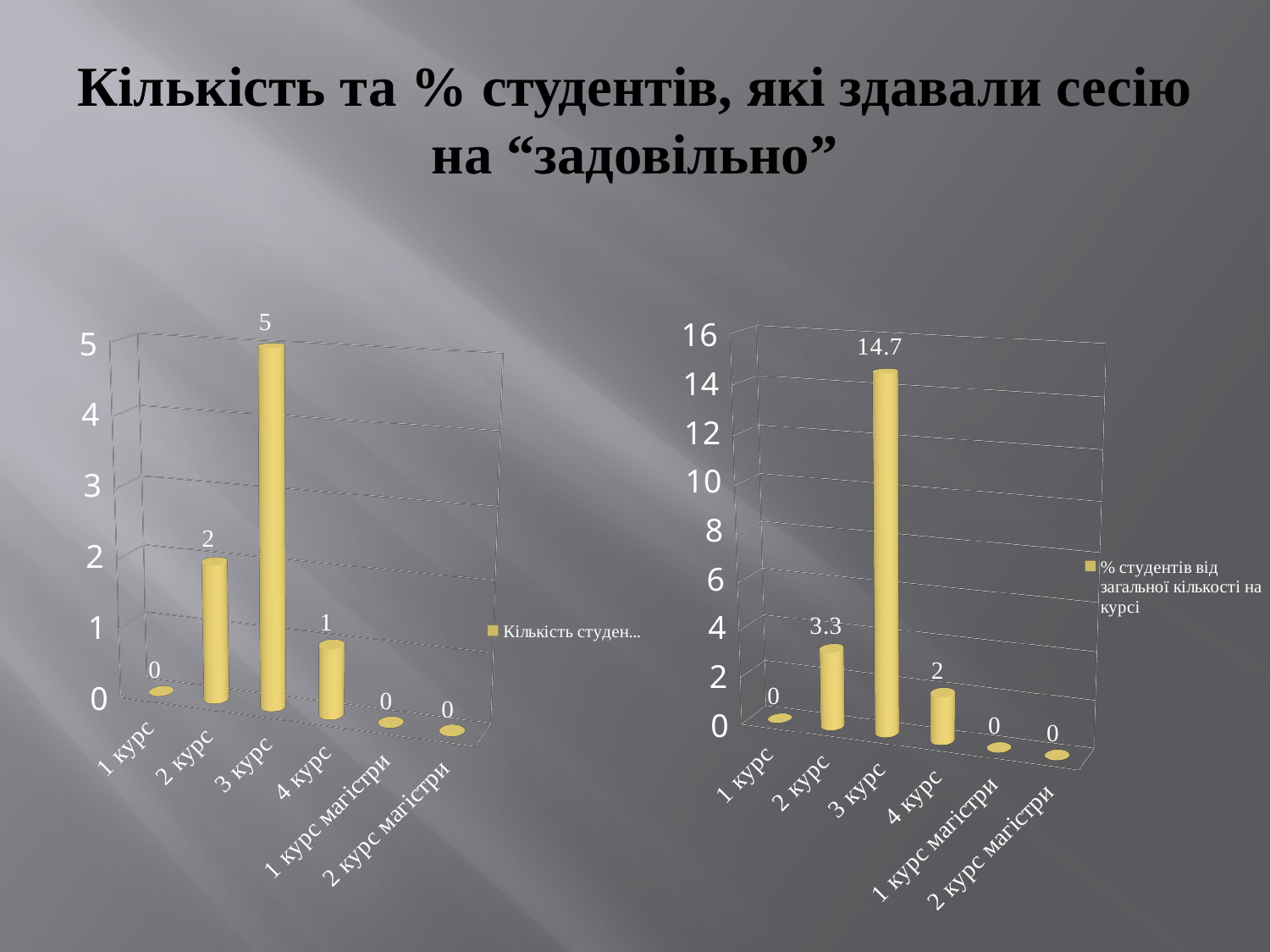
In the left chart, which is larger: the value for 2 курс or the value for 4 курс? 2 курс In the left chart, what is the value for 2 курс? 2 In the right chart, which category has the highest value? 3 курс In the left chart, what is the difference between the values for 3 курс and 2 курс? 3 What type of chart is the left chart? bar chart In the right chart, what is the value for 3 курс? 14.7 How many categories are shown on the x axis of the right chart? 6 In the right chart, what is the difference between the values for 3 курс and 2 курс? 11.4 In the left chart, what is the value for 3 курс? 5 In the right chart, what is the value for 2 курс? 3.3 In the right chart, what is the value for 4 курс? 2 In the left chart, which category has the highest value? 3 курс